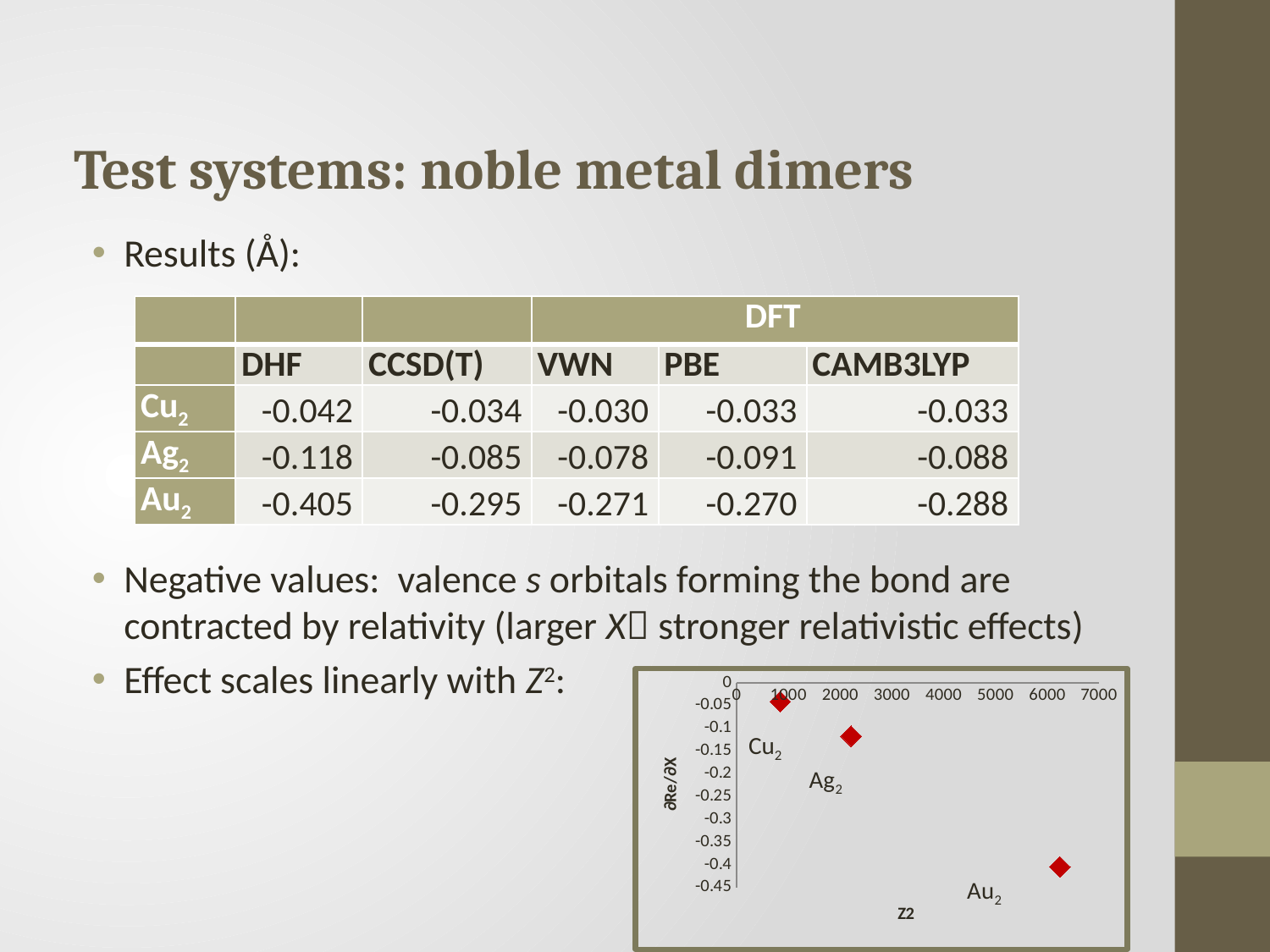
Which point in the chart has the lowest (most negative) value on the y axis? Au2 In the chart, is the y value for Au2 greater or less than -0.3? less In the chart, is the Z2 value for Au2 greater or less than 6000? greater What kind of chart is shown on the slide? scatter chart How many data points are plotted in the chart? 3 In the chart, is the y value for Cu2 greater or less than -0.1? greater What is the title of the x axis of the chart? Z2 Do the plotted y values rise or fall as Z2 increases along the x axis? fall Which point in the chart has the highest value on the y axis? Cu2 In the chart, which has the larger y value, Cu2 or Ag2? Cu2